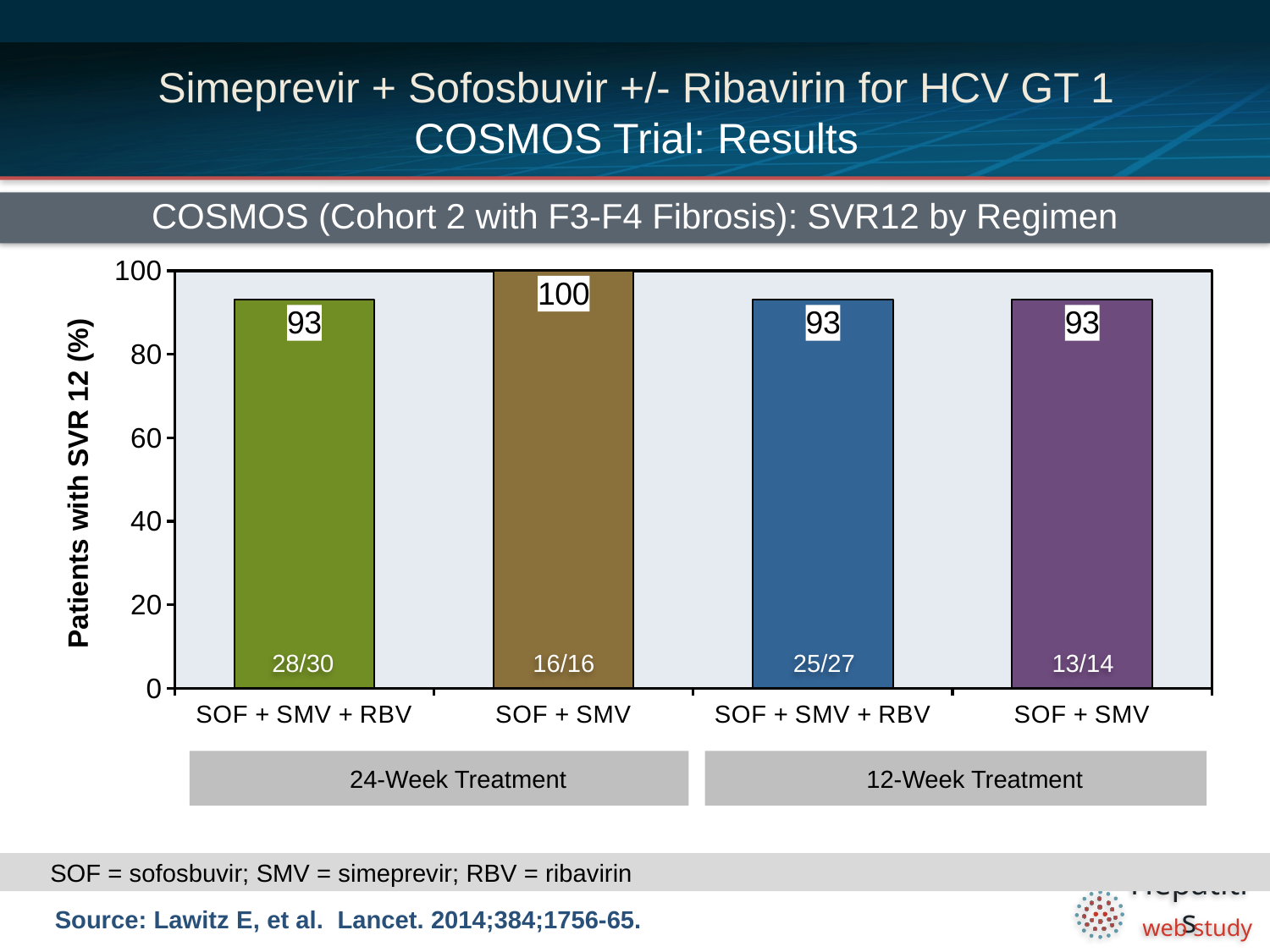
What fraction of patients is shown inside the bar for SOF + SMV + RBV in the 24-Week Treatment group? 28/30 What is the title of the chart? COSMOS (Cohort 2 with F3-F4 Fibrosis): SVR12 by Regimen Which regimen has the highest SVR12 rate? SOF + SMV (24-Week Treatment) What is the SVR12 rate for SOF + SMV + RBV in the 12-Week Treatment group? 93 What is the SVR12 rate for SOF + SMV in the 24-Week Treatment group? 100 What is the difference in SVR12 rate between SOF + SMV in the 24-Week group and SOF + SMV in the 12-Week group? 7 Which is larger: the SVR12 rate for SOF + SMV in the 24-Week group or for SOF + SMV + RBV in the 24-Week group? SOF + SMV in the 24-Week group What fraction of patients is shown inside the bar for SOF + SMV in the 12-Week Treatment group? 13/14 What type of chart is shown on the slide? Bar chart What is the label of the y-axis? Patients with SVR 12 (%) Is the SVR12 rate for SOF + SMV + RBV in the 12-Week Treatment group greater or less than 80? greater How many bars are shown in the chart? 4